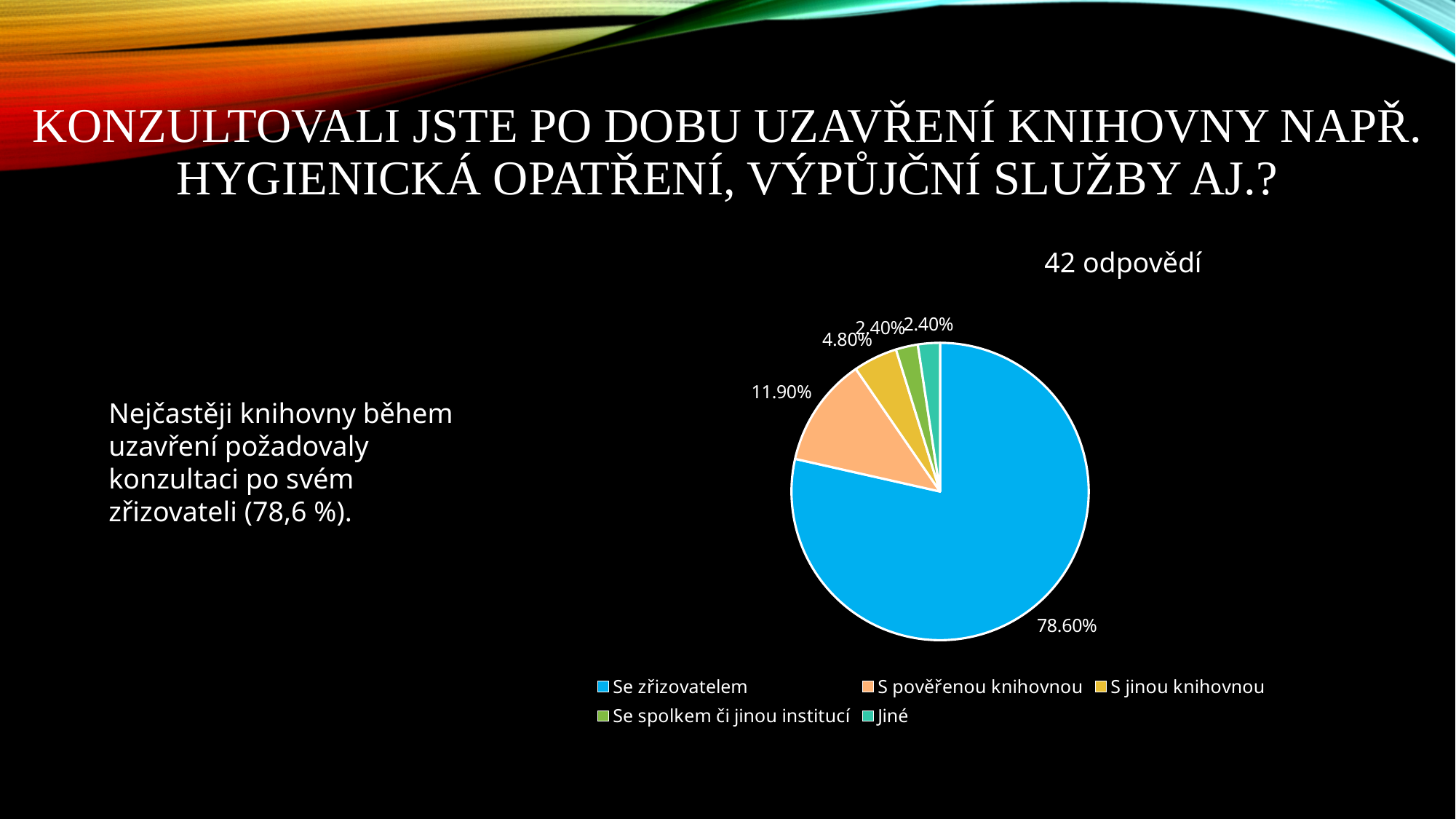
What is the value shown for "S jinou knihovnou"? 4.80% What type of chart is shown on the slide? pie chart How many categories does the pie chart show? 5 What share of the pie does "Se zřizovatelem" have? 78.60% How many responses does the chart heading say were collected? 42 What is the value shown for "Se spolkem či jinou institucí"? 2.40% Which category has the largest slice of the pie? Se zřizovatelem What is the value shown for "S pověřenou knihovnou"? 11.90% Which is larger, the value for "S pověřenou knihovnou" or the value for "S jinou knihovnou"? S pověřenou knihovnou What is the difference between the values for "Se zřizovatelem" and "S pověřenou knihovnou"? 66.70% What is the value shown for "Jiné"? 2.40% What is the difference between the values for "S jinou knihovnou" and "Jiné"? 2.40%